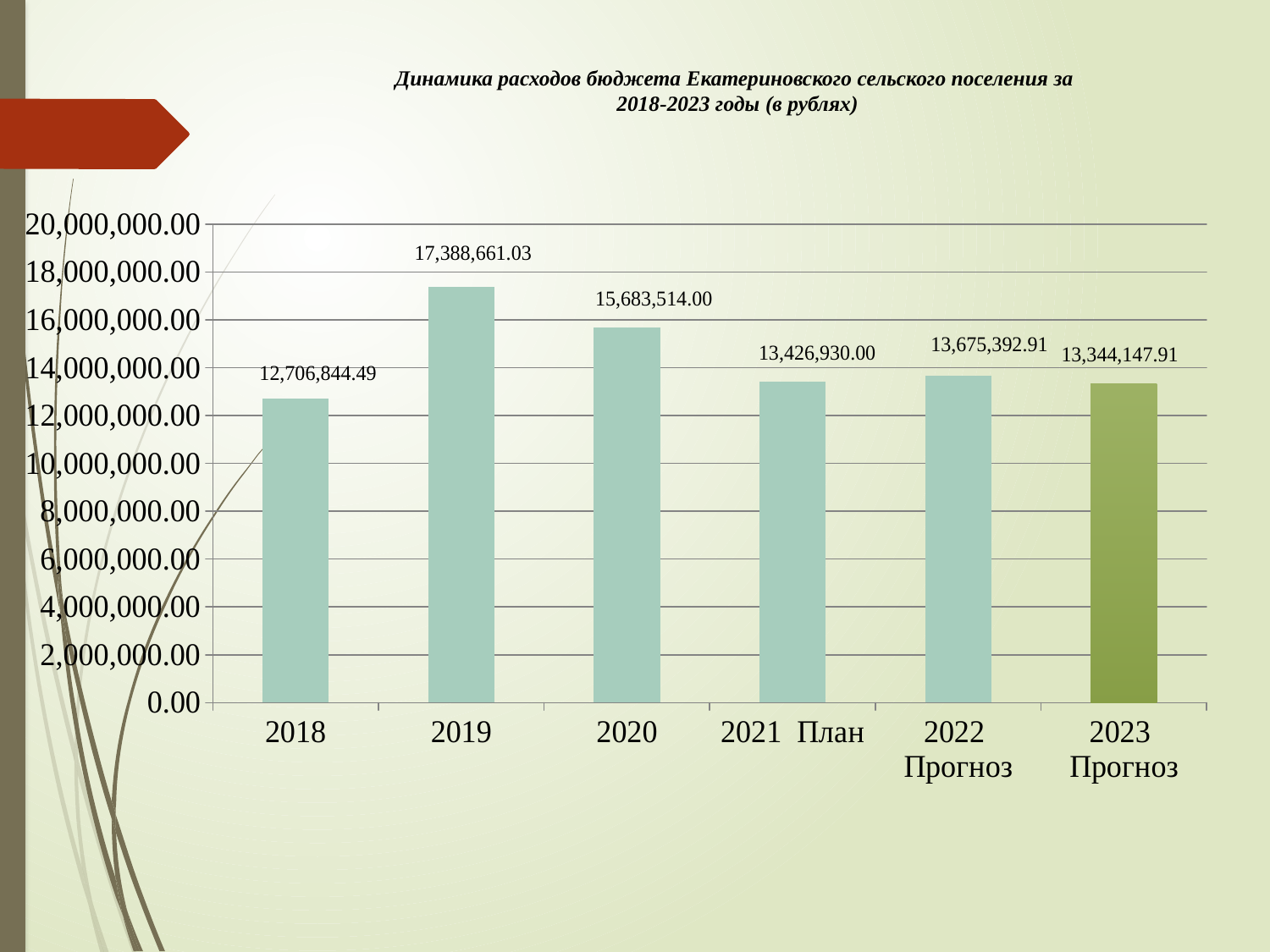
What is the value for 2023 Прогноз? 13,344,147.91 How many bars are shown in the chart? 6 What type of chart is shown on the slide? Bar chart Which year has the lowest value? 2018 Which year has the highest value? 2019 What is the difference between the values for 2020 and 2021 План? 2,256,584.00 What is the value for 2021 План? 13,426,930.00 What is the difference between the values for 2019 and 2018? 4,681,816.54 What is the value for 2018? 12,706,844.49 What is the value for 2019? 17,388,661.03 Which bar is shown in a different (darker green) colour from the others? 2023 Прогноз Which is larger, the value for 2022 Прогноз or 2023 Прогноз? 2022 Прогноз